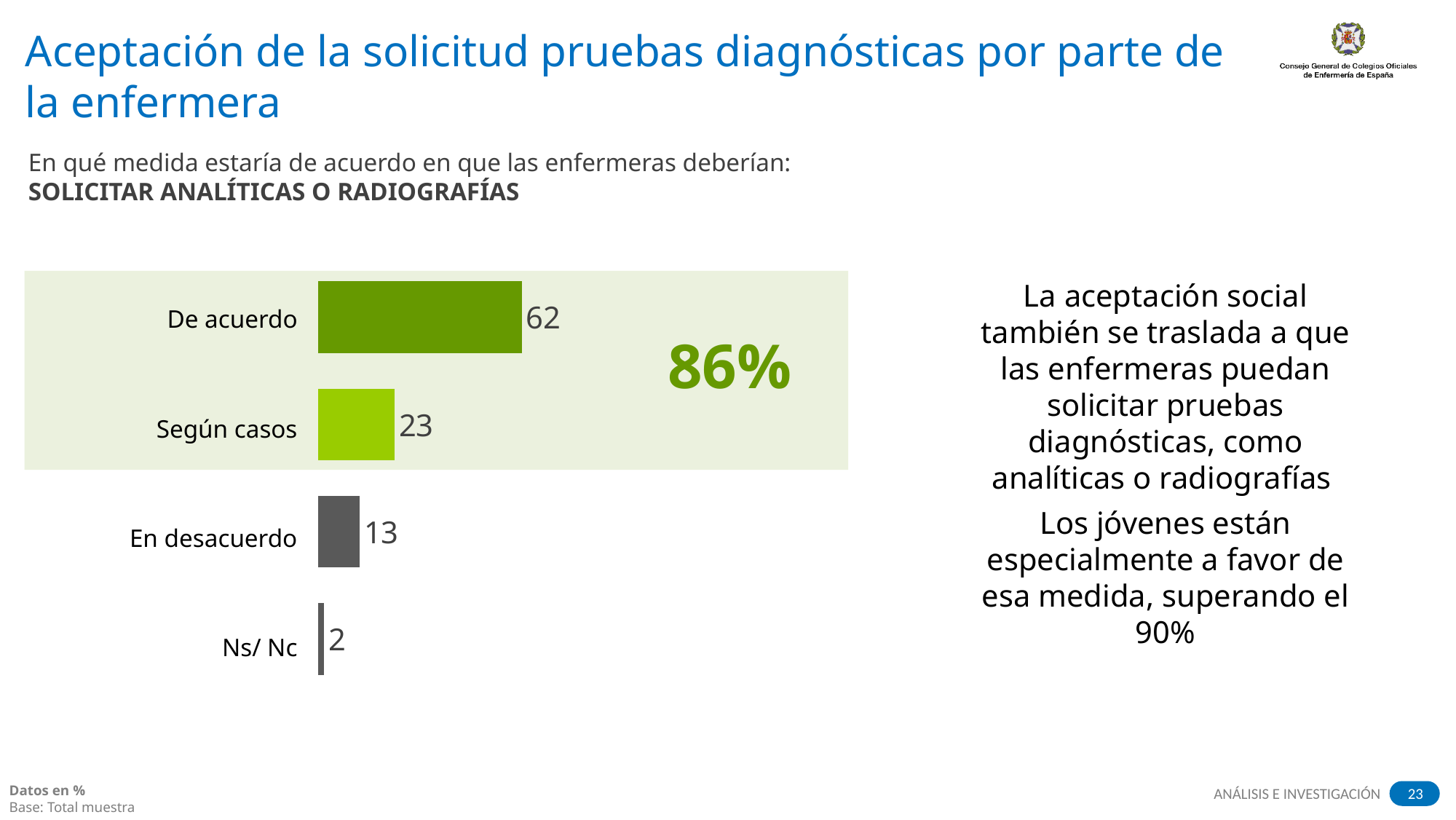
What is the combined value of "En desacuerdo" and "Ns/ Nc"? 15 What is the value for "En desacuerdo"? 13 Which category has the lowest value? Ns/ Nc What is the difference between the values for "De acuerdo" and "Según casos"? 39 What is the value for "Según casos"? 23 What is the value for "De acuerdo"? 62 What kind of chart is shown on the slide? Bar chart Which is larger, the value for "Según casos" or the value for "En desacuerdo"? Según casos What is the combined total of "De acuerdo" and "Según casos" as highlighted on the chart? 86% Which category has the highest value? De acuerdo How many categories are shown in the chart? 4 What is the value for "Ns/ Nc"? 2